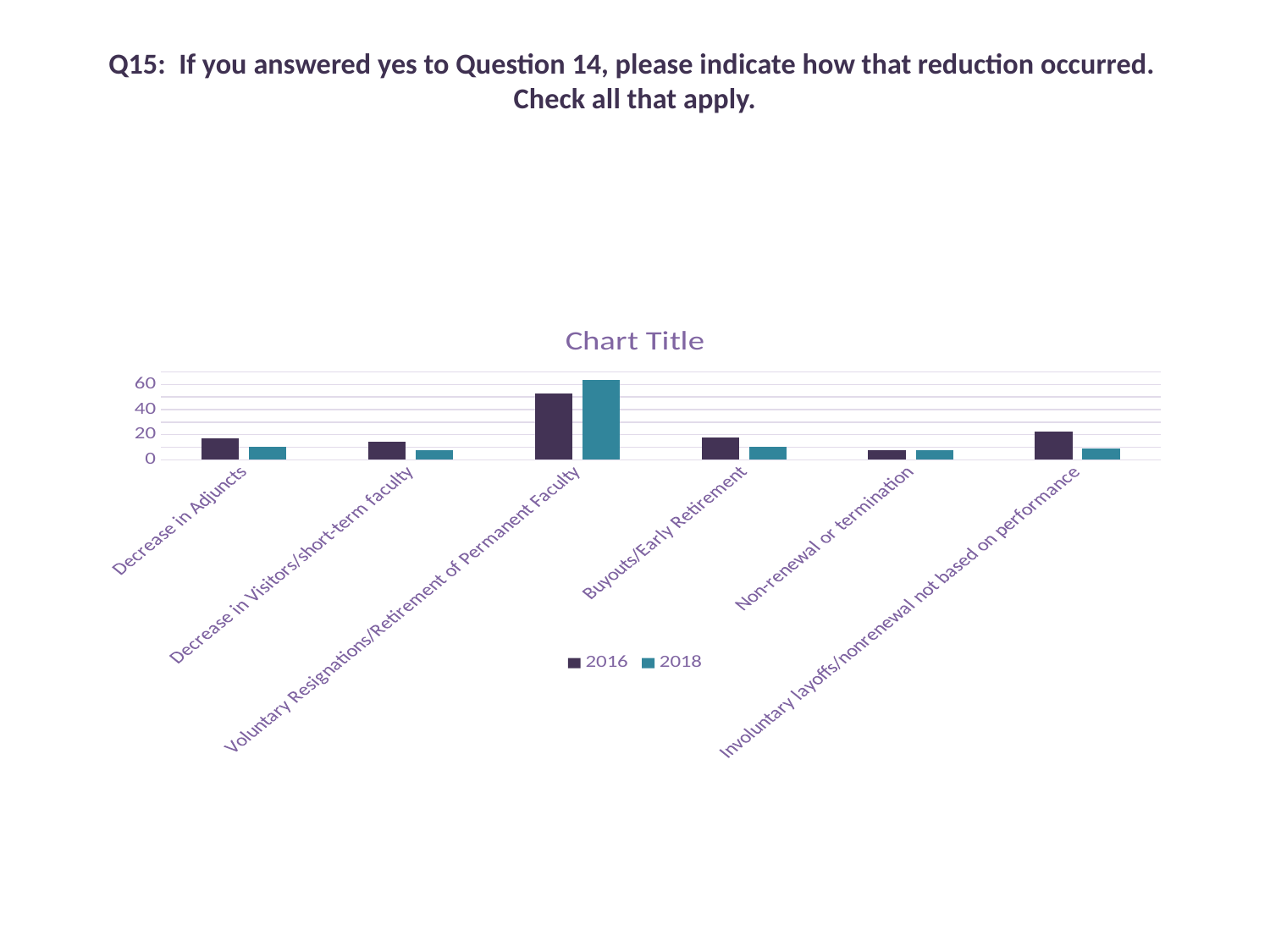
How many series does the legend list? 2 For Voluntary Resignations/Retirement of Permanent Faculty, which series has the larger value, 2016 or 2018? 2018 Is the 2016 value for Decrease in Adjuncts greater or less than 20? less Which category has the highest value for the 2016 series? Voluntary Resignations/Retirement of Permanent Faculty Is the 2016 value for Voluntary Resignations/Retirement of Permanent Faculty greater or less than 40? greater Which category has the highest value for the 2018 series? Voluntary Resignations/Retirement of Permanent Faculty Is the 2018 value for Voluntary Resignations/Retirement of Permanent Faculty greater or less than 60? greater What are the two entries listed in the chart legend? 2016 and 2018 For Involuntary layoffs/nonrenewal not based on performance, which series has the larger value, 2016 or 2018? 2016 What kind of chart is shown on the slide? bar chart How many categories are shown on the x axis? 6